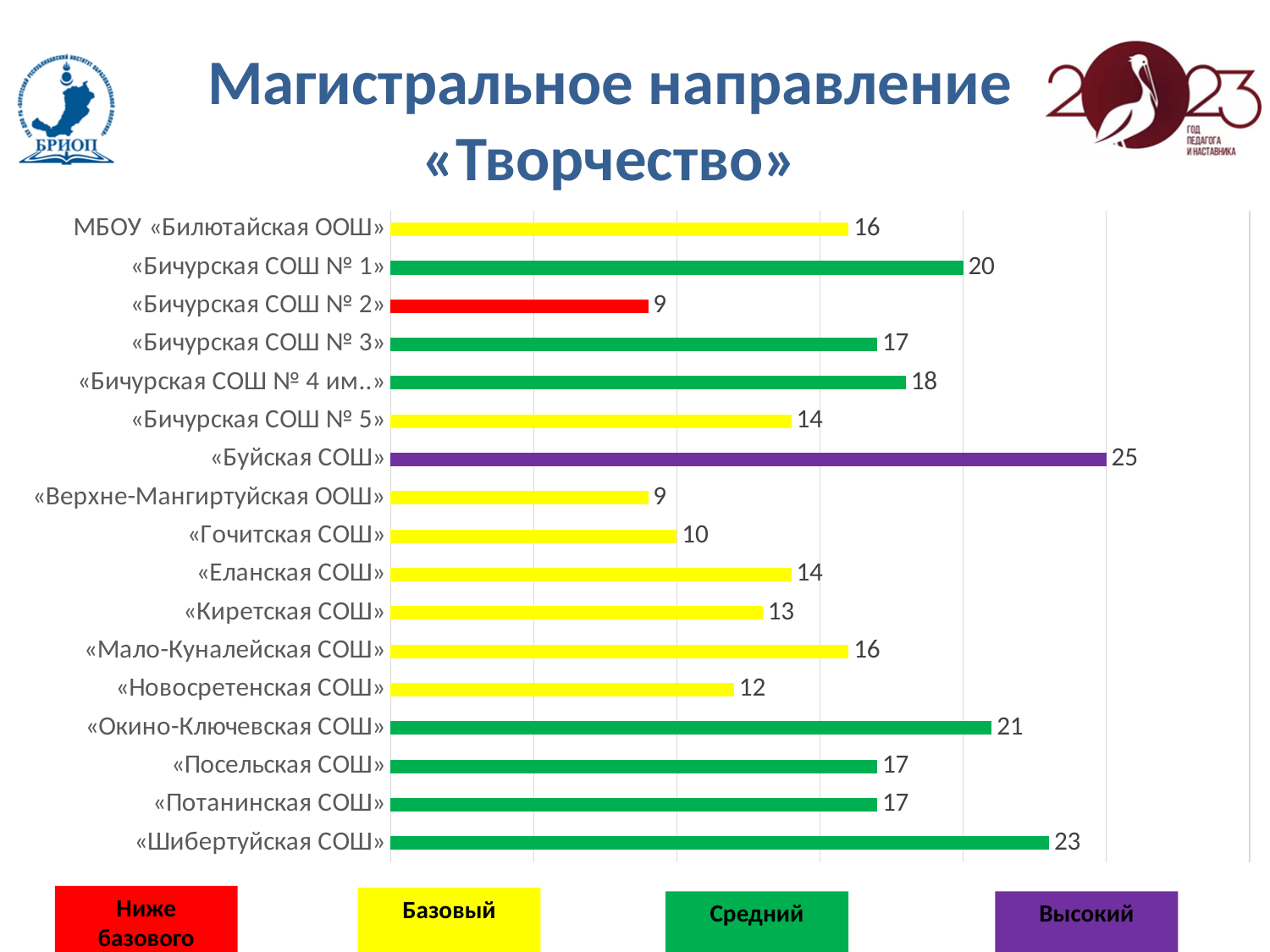
What is the value for «Буйская СОШ»? 25 What kind of chart is shown on the slide? Bar chart What is the value for «Бичурская СОШ № 2»? 9 Which school has the highest value on the chart? «Буйская СОШ» What is the value for «Окино-Ключевская СОШ»? 21 Which has a larger value, «Киретская СОШ» or «Мало-Куналейская СОШ»? «Мало-Куналейская СОШ» What is the value for «Новосретенская СОШ»? 12 What is the lowest value shown on the chart? 9 How many schools are shown on the chart? 17 What is the difference between the values for «Шибертуйская СОШ» and «Гочитская СОШ»? 13 What is the difference between the values for «Бичурская СОШ № 1» and «Бичурская СОШ № 5»? 6 Which level does the red bar colour represent according to the legend below the chart? Ниже базового